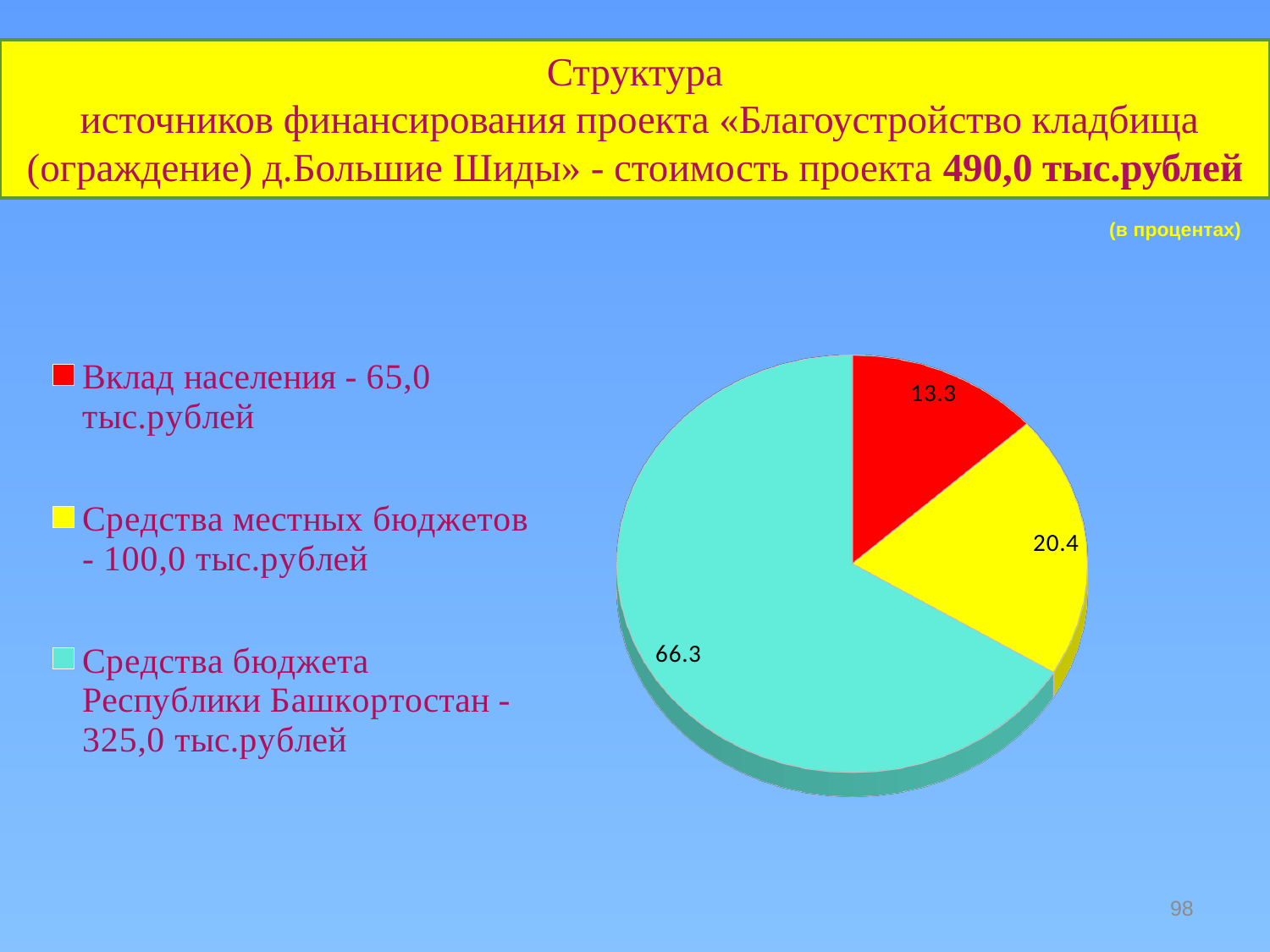
What value is shown for the slice "Средства бюджета Республики Башкортостан"? 66.3 What value is shown for the slice "Вклад населения"? 13.3 How many entries does the legend list? 3 What colour is the slice for "Вклад населения"? red How many slices does the pie chart have? 3 Which is larger: the share for "Средства местных бюджетов" or for "Вклад населения"? Средства местных бюджетов According to the legend, how much money comes from "Средства бюджета Республики Башкортостан"? 325,0 тыс.рублей Which source has the smallest share of the pie? Вклад населения What type of chart is shown on the slide? pie chart What is the difference between the values for "Средства местных бюджетов" and "Вклад населения"? 7.1 Which source has the largest share of the pie? Средства бюджета Республики Башкортостан What value is shown for the slice "Средства местных бюджетов"? 20.4